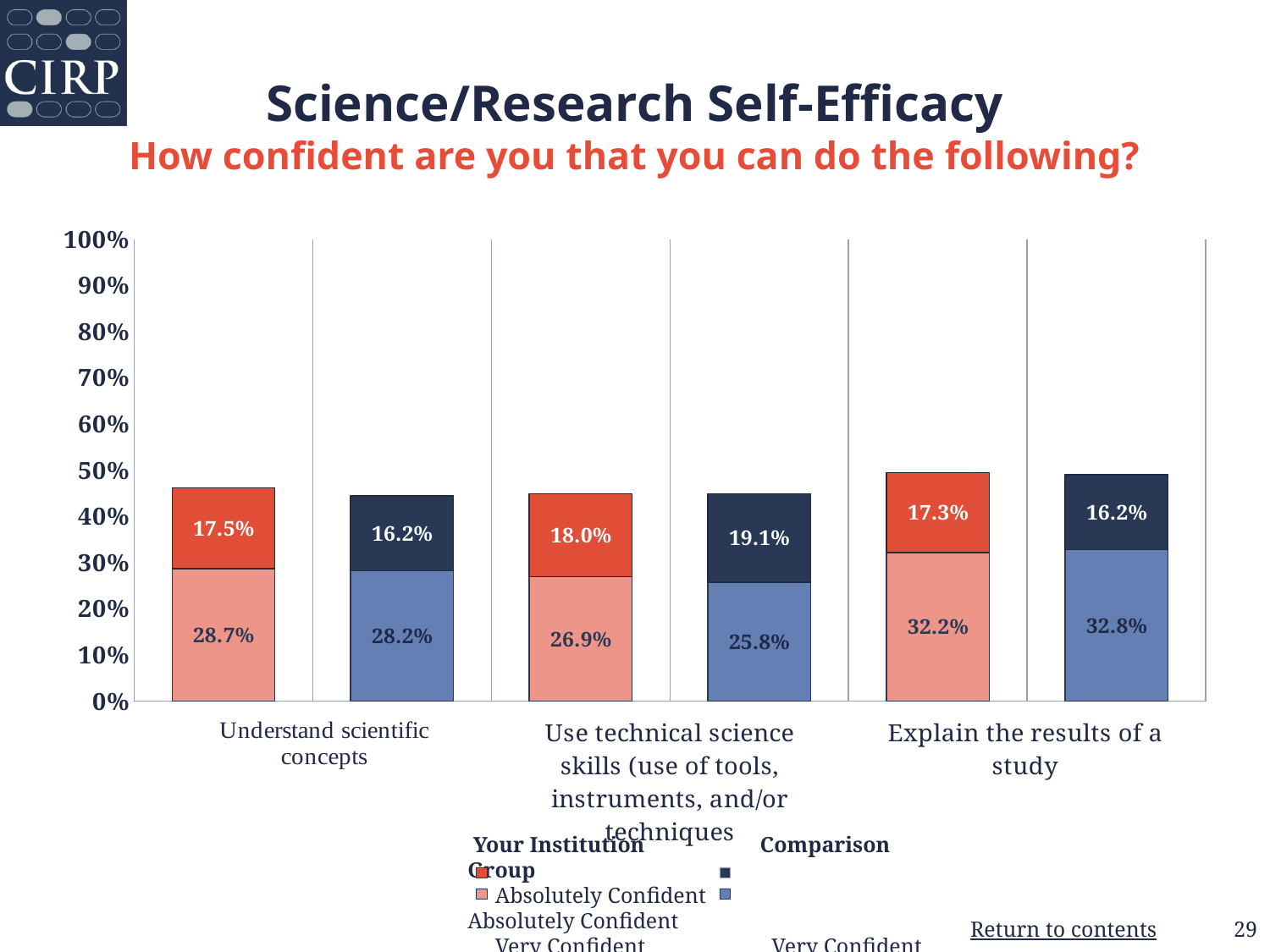
What is the total of the Comparison Group stacked bar for 'Explain the results of a study'? 49.0% What is the difference between the Very Confident values for Your Institution and the Comparison Group for 'Use technical science skills'? 1.1% What percentage of Your Institution students are Very Confident they can understand scientific concepts? 17.5% Is the total of the Your Institution stacked bar for 'Explain the results of a study' greater or less than 50%? less What percentage of Your Institution students are Absolutely Confident they can explain the results of a study? 32.2% What percentage of the Comparison Group is Very Confident they can explain the results of a study? 16.2% How many items (categories) are shown on the x axis? 3 What is the total of the Your Institution stacked bar for 'Understand scientific concepts'? 46.2% Among the Your Institution bars, which item has the highest Very Confident value? Use technical science skills (use of tools, instruments, and/or techniques) Which is larger for 'Understand scientific concepts': the Absolutely Confident value for Your Institution or for the Comparison Group? Your Institution What percentage of the Comparison Group is Absolutely Confident they can use technical science skills? 25.8% What kind of chart is shown on the slide? stacked bar chart